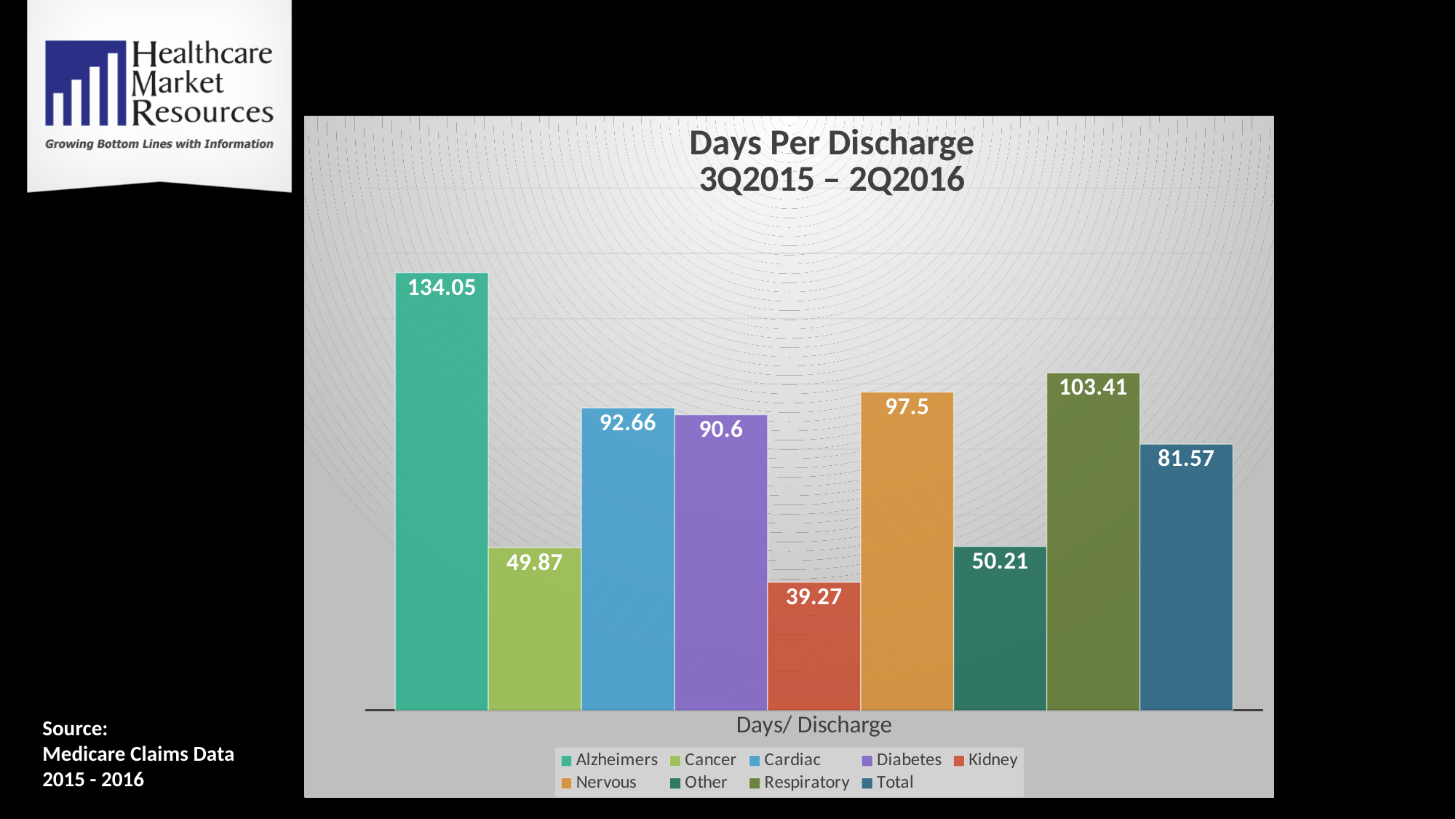
Which category has the highest days per discharge? Alzheimers What is the title of the chart? Days Per Discharge 3Q2015 – 2Q2016 What is the days per discharge value for Kidney? 39.27 How many series does the legend list? 9 What is the days per discharge value for Total? 81.57 What is the difference between the Alzheimers and Respiratory values? 30.64 What is the difference between the Nervous and Cardiac values? 4.84 What kind of chart is shown on the slide? Bar chart What is the days per discharge value for Respiratory? 103.41 Which category has the lowest days per discharge? Kidney Which is larger, the value for Cancer or the value for Other? Other What is the days per discharge value for Alzheimers? 134.05